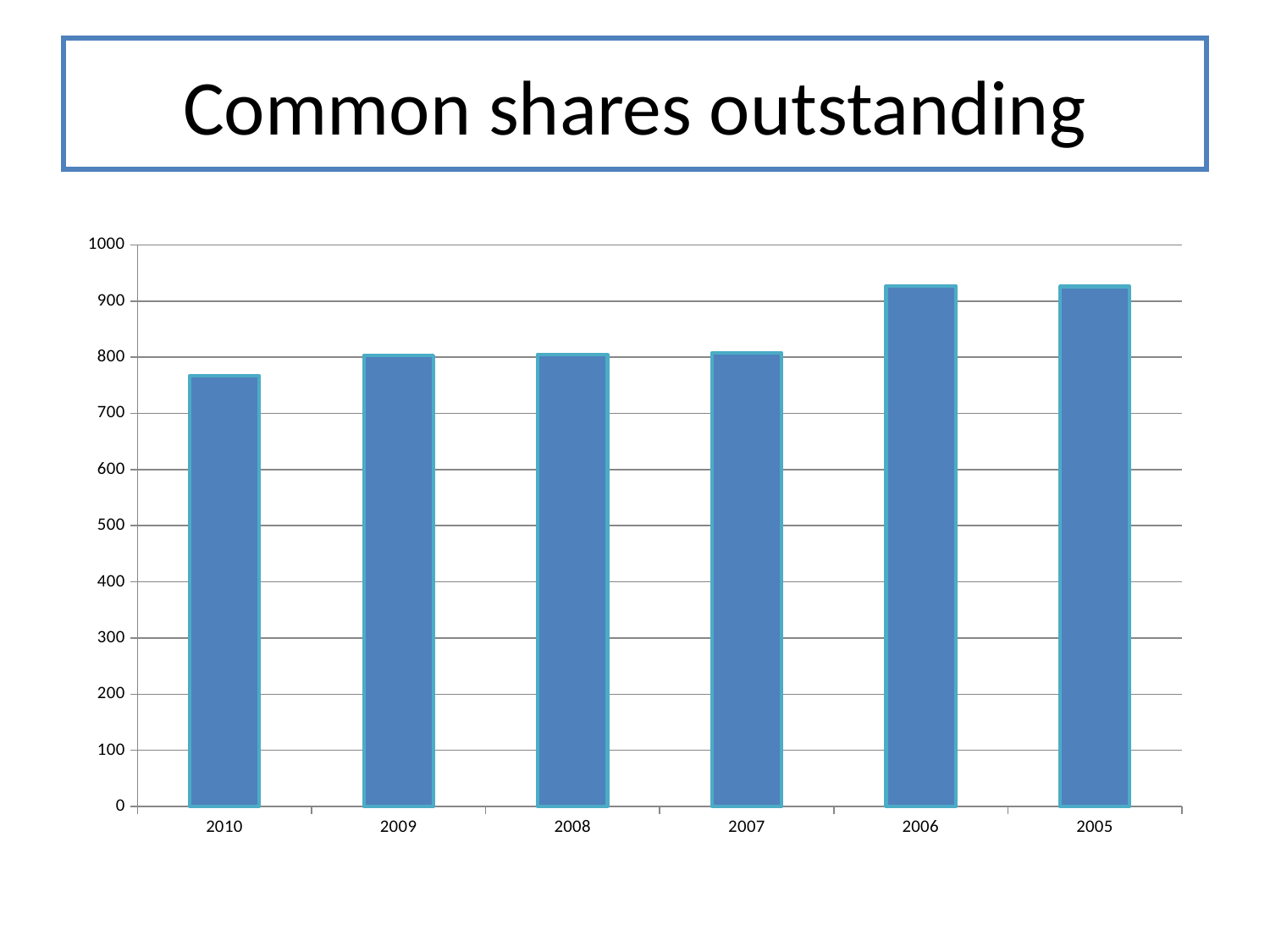
Which year has the lowest value in the chart? 2010 What kind of chart is shown on the slide? bar chart Is the value for 2010 greater or less than 800? less Which is larger, the value for 2010 or the value for 2006? 2006 Is the value for 2005 greater or less than 900? greater Is the value for 2006 greater or less than 900? greater Moving left to right along the x axis from 2010 to 2005, do the values generally rise or fall? rise How many years are shown on the x axis of the chart? 6 Which is larger, the value for 2009 or the value for 2005? 2005 What is the title of the chart? Common shares outstanding